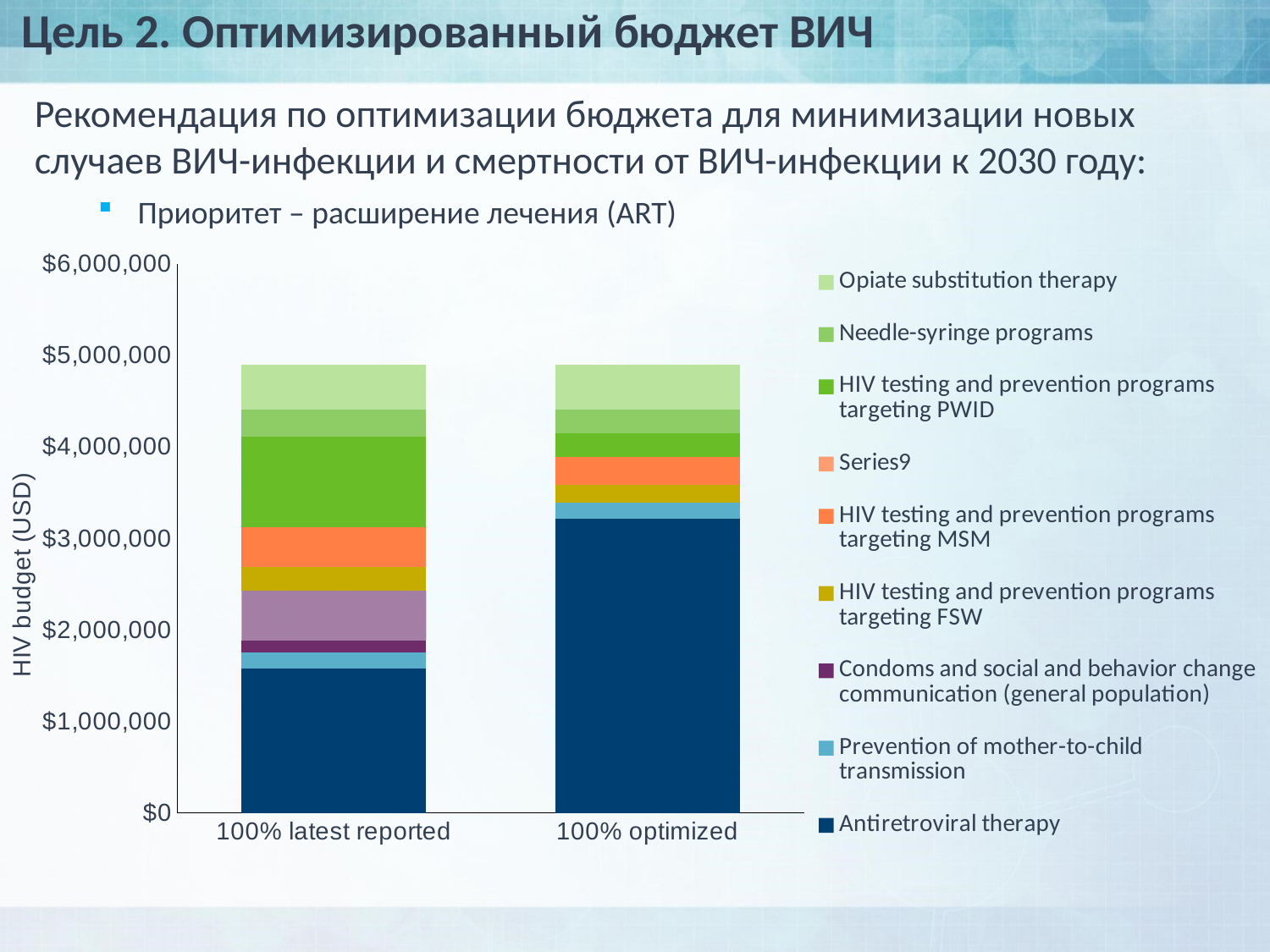
What are the two category labels on the x axis? 100% latest reported; 100% optimized Which series is shown at the bottom of each stacked bar? Antiretroviral therapy Is the total height of the "100% optimized" bar greater or less than $4,000,000? greater How many series does the legend list? 9 Which bar has the larger Antiretroviral therapy segment, "100% latest reported" or "100% optimized"? 100% optimized What kind of chart is shown on the slide? stacked bar chart Is the Antiretroviral therapy segment for "100% optimized" greater or less than $3,000,000? greater Is the Antiretroviral therapy segment for "100% latest reported" greater or less than $2,000,000? less What is the title of the vertical axis? HIV budget (USD) How many bars (categories) are plotted on the x axis? 2 Which bar has the larger segment for HIV testing and prevention programs targeting PWID, "100% latest reported" or "100% optimized"? 100% latest reported